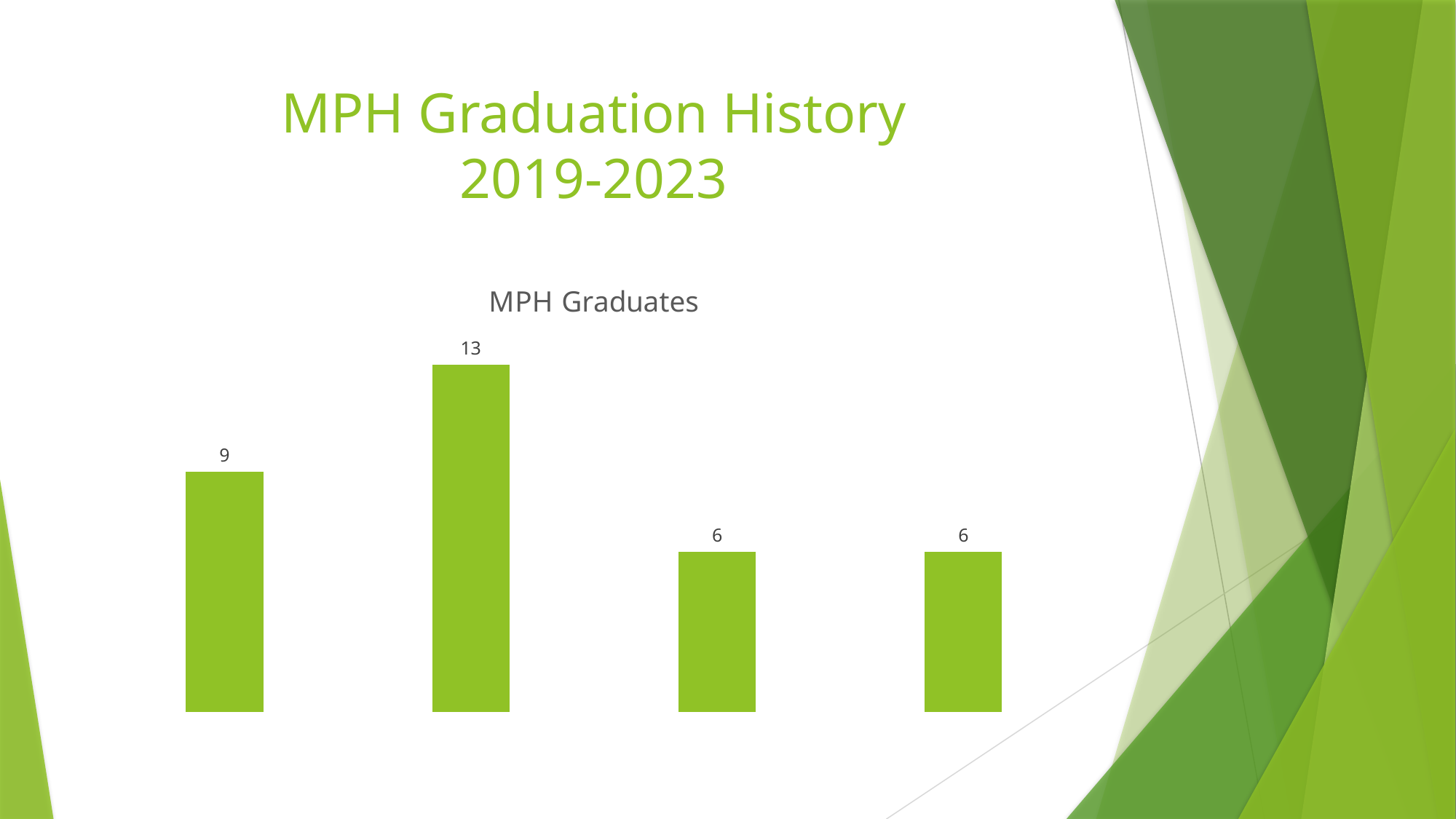
How many bars are plotted in the MPH Graduates chart? 4 What is the value shown on the third bar from the left in the MPH Graduates chart? 6 What type of chart is shown on the slide? Bar chart What is the difference between the second bar (13) and the first bar (9) in the MPH Graduates chart? 4 What is the lowest value shown in the MPH Graduates chart? 6 Which bar in the MPH Graduates chart has the highest value? The second bar from the left (13) What is the value shown on the first (leftmost) bar in the MPH Graduates chart? 9 What is the value shown on the second bar from the left in the MPH Graduates chart? 13 What is the highest value shown in the MPH Graduates chart? 13 Which is larger in the MPH Graduates chart: the first bar or the third bar? The first bar (9) What is the difference between the highest and lowest values in the MPH Graduates chart? 7 What is the value shown on the rightmost bar in the MPH Graduates chart? 6